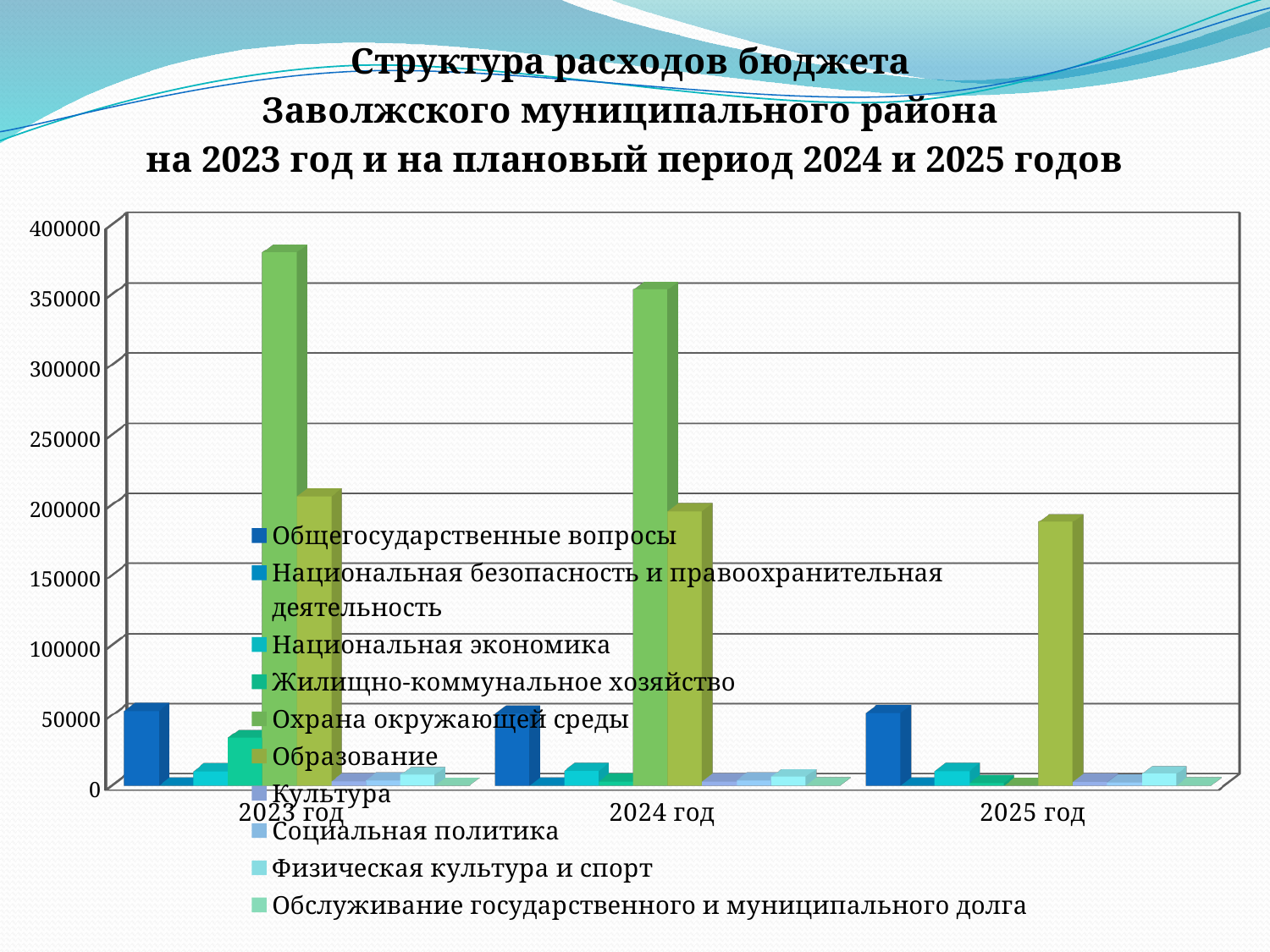
How many year categories are shown on the x axis? 3 Is the value for Общегосударственные вопросы in 2023 год greater or less than 100000? less What is the first series listed in the legend? Общегосударственные вопросы Which is larger: the tallest bar for 2023 год or the tallest bar for 2025 год? 2023 год Does the tallest bar in each year rise or fall from 2023 год to 2025 год? fall Is the tallest bar for 2025 год greater or less than 200000? less How many series does the legend list? 10 What is the last series listed in the legend? Обслуживание государственного и муниципального долга Is the tallest bar for 2023 год greater or less than 350000? greater What kind of chart is shown on the slide? bar chart Which year has the tallest bar in the chart? 2023 год